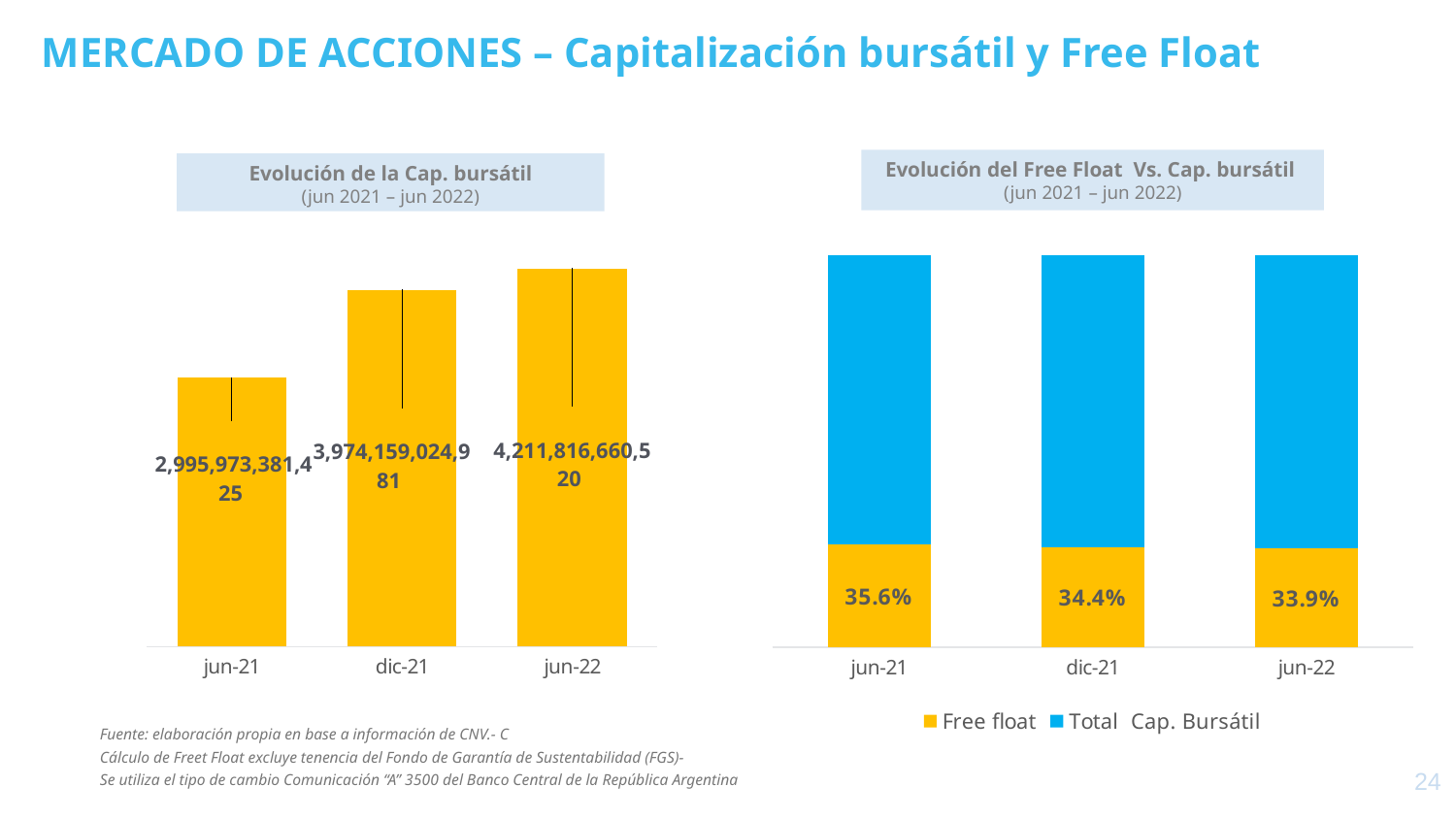
In the chart 'Evolución de la Cap. bursátil', what is the value for jun-21? 2,995,973,381,425 In the chart 'Evolución del Free Float Vs. Cap. bursátil', what is the Free float percentage for dic-21? 34.4% In the chart 'Evolución de la Cap. bursátil', do the values rise or fall from jun-21 to jun-22? rise In the chart 'Evolución de la Cap. bursátil', which period has the highest value? jun-22 In the chart 'Evolución del Free Float Vs. Cap. bursátil', what is the difference in Free float percentage between jun-21 and jun-22? 1.7 percentage points In the chart 'Evolución de la Cap. bursátil', what is the difference between the jun-22 and dic-21 values? 237,657,635,539 What kind of chart is 'Evolución del Free Float Vs. Cap. bursátil'? stacked bar chart In the chart 'Evolución del Free Float Vs. Cap. bursátil', how many series does the legend list? 2 In the chart 'Evolución del Free Float Vs. Cap. bursátil', which period has the lowest Free float percentage? jun-22 In the chart 'Evolución de la Cap. bursátil', what is the value for jun-22? 4,211,816,660,520 In the chart 'Evolución de la Cap. bursátil', which period has the lowest value? jun-21 In the chart 'Evolución de la Cap. bursátil', how many periods are plotted? 3